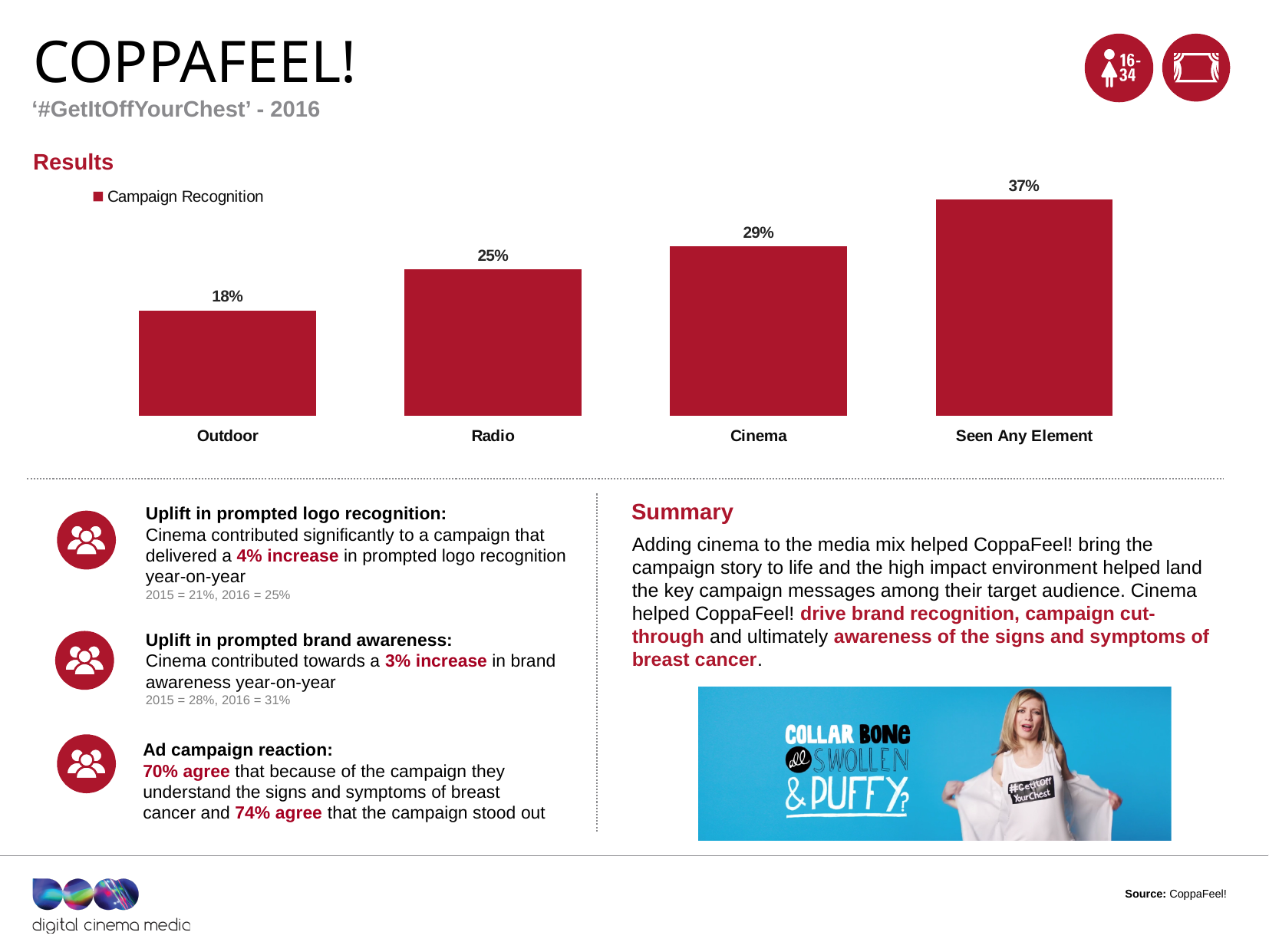
How many series does the chart legend list? 1 What is the campaign recognition value for Outdoor? 18% What is the difference in campaign recognition between Cinema and Radio? 4% Do the campaign recognition values rise or fall from left to right across the categories? Rise Which category has the highest campaign recognition? Seen Any Element Which category has the lowest campaign recognition? Outdoor Which has higher campaign recognition, Cinema or Radio? Cinema What is the campaign recognition value for Radio? 25% What kind of chart is shown on the slide? Bar chart What is the difference in campaign recognition between Seen Any Element and Outdoor? 19% How many categories are shown in the chart? 4 What is the campaign recognition value for Cinema? 29%